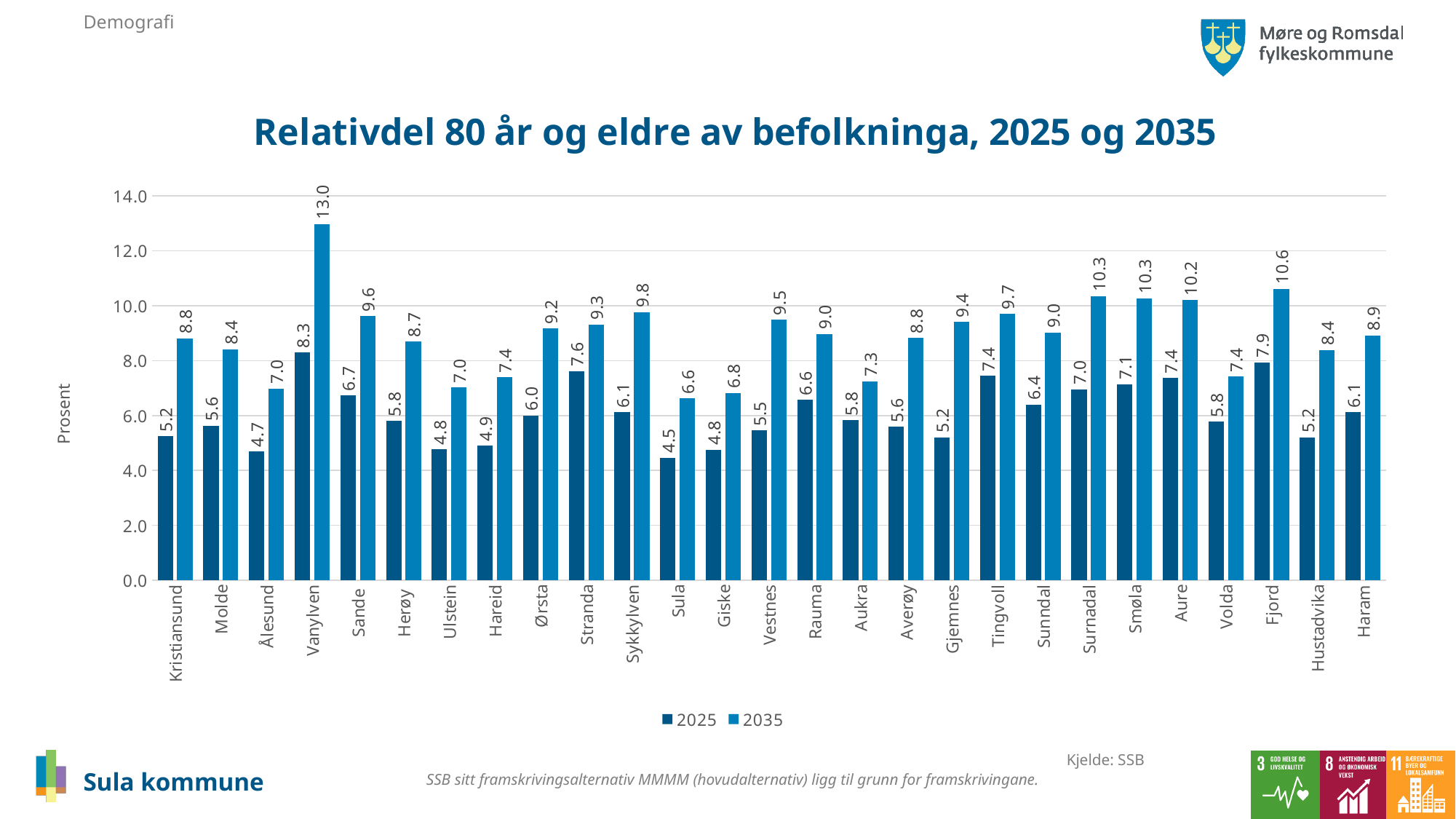
Which is larger, the 2035 value for Surnadal or the 2035 value for Aure? Surnadal Which municipality has the lowest 2025 value? Sula Is the 2025 value for Fjord greater or less than 6.0? greater Which municipality has the lowest 2035 value? Sula What is the 2035 value for Fjord? 10.6 What is the 2025 value for Sula? 4.5 How many municipalities are shown on the x axis? 27 What is the difference between the 2035 and 2025 values for Vanylven? 4.7 Which municipality has the highest 2035 value? Vanylven How many series does the legend list? 2 What is the 2035 value for Vanylven? 13.0 What kind of chart is shown on the slide? Bar chart